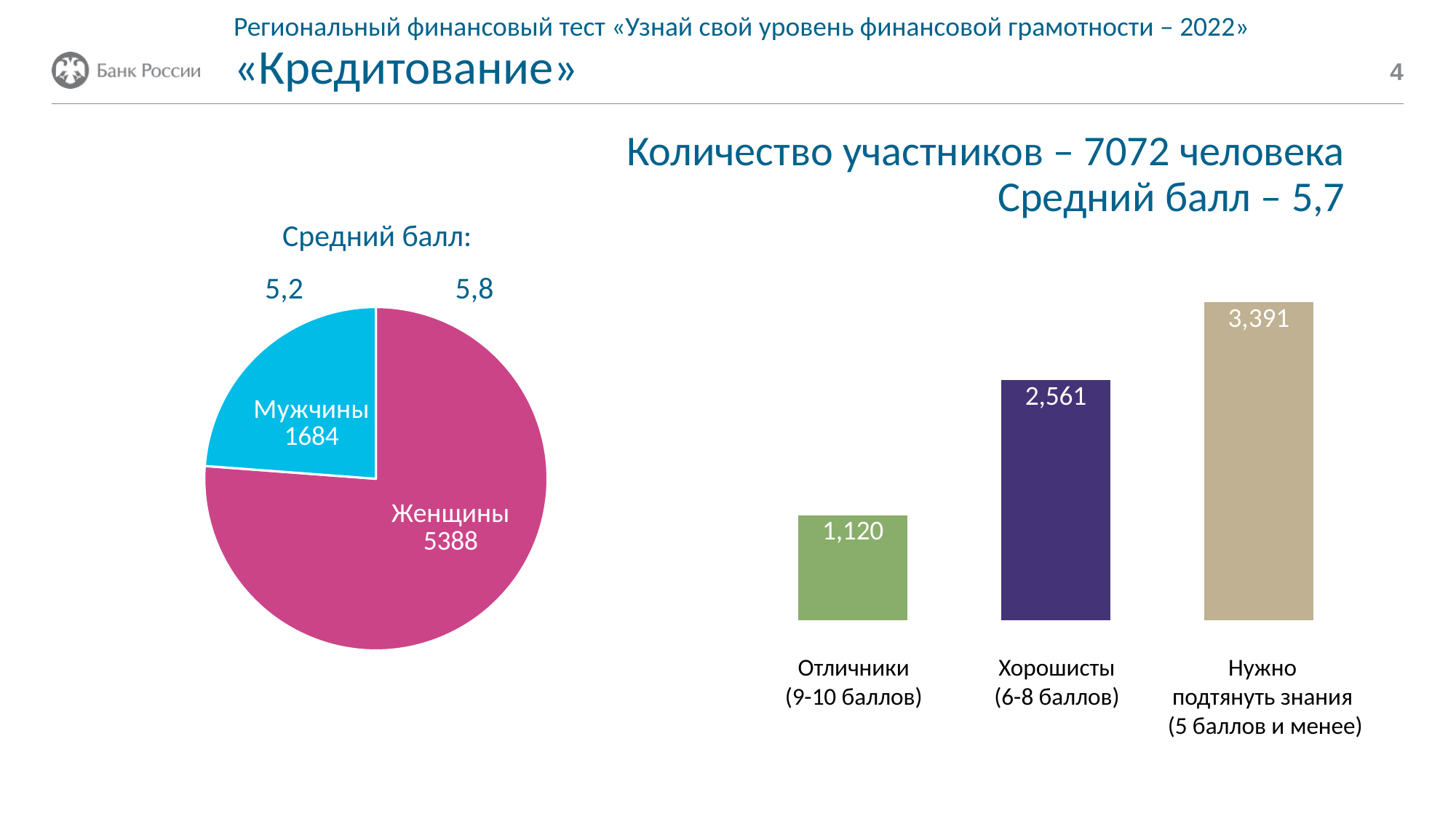
In the pie chart on the left, which slice is larger, Мужчины or Женщины? Женщины What kind of chart is the chart on the left of the slide? Pie chart How many categories are shown in the bar chart on the right? 3 In the bar chart on the right, what is the value for Хорошисты (6-8 баллов)? 2,561 In the pie chart on the left, what is the value for Женщины? 5388 In the bar chart on the right, which category has the highest value? Нужно подтянуть знания (5 баллов и менее) In the pie chart on the left, what is the value for Мужчины? 1684 In the bar chart on the right, which category has the lowest value? Отличники (9-10 баллов) In the pie chart on the left, what is the difference between the values for Женщины and Мужчины? 3704 In the bar chart on the right, what is the difference between the values for Нужно подтянуть знания and Хорошисты? 830 In the bar chart on the right, what is the value for Отличники (9-10 баллов)? 1,120 In the pie chart on the left, what is the average score (Средний балл) shown for Мужчины? 5,2